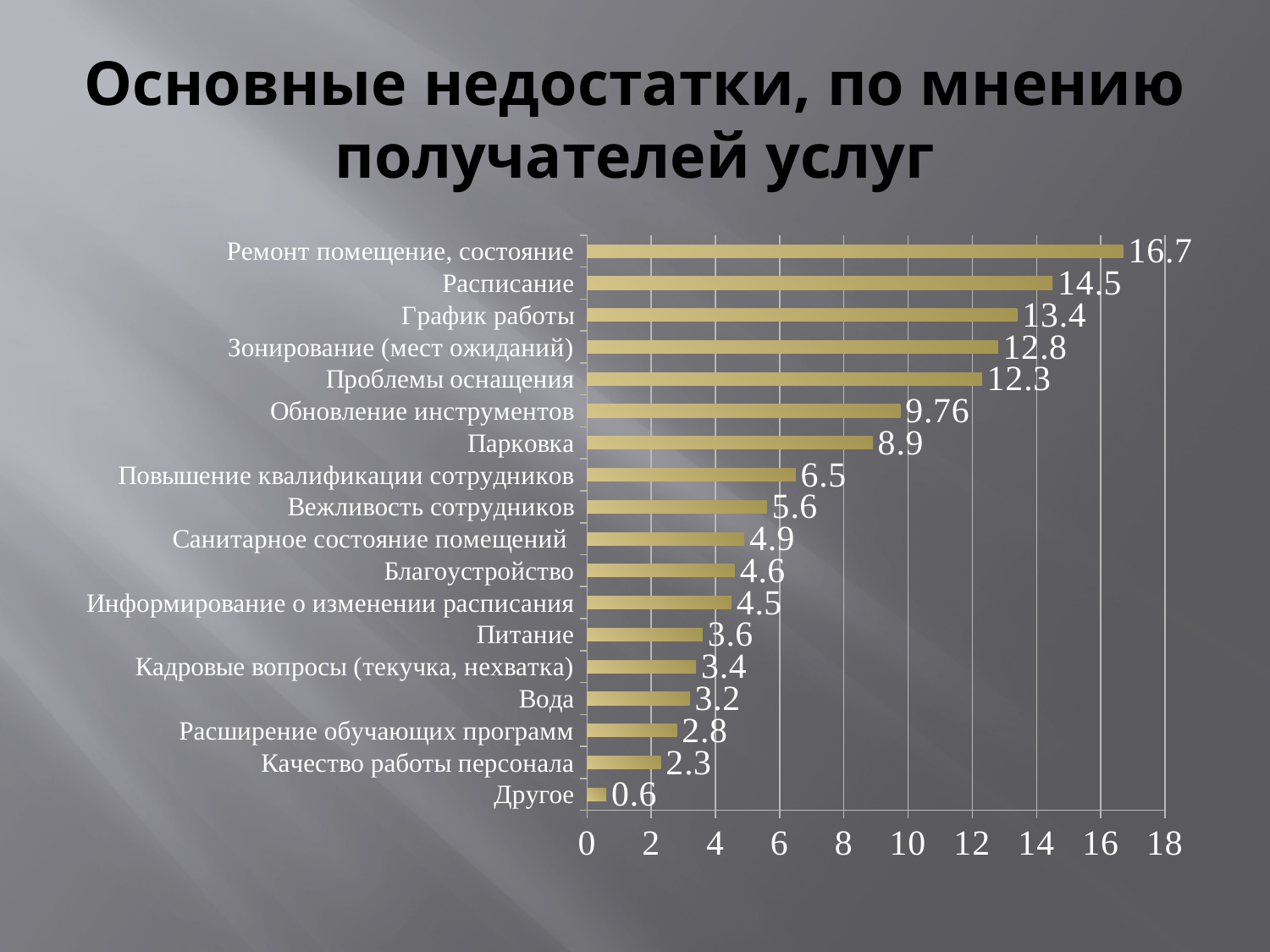
What is the value for Обновление инструментов? 9.76 What is the title of the slide? Основные недостатки, по мнению получателей услуг What is the difference between the values for Ремонт помещение, состояние and Расписание? 2.2 How many categories are shown in the chart? 18 What is the value for Расписание? 14.5 What kind of chart is shown on the slide? bar chart Is the value for Зонирование (мест ожиданий) greater or less than 10? greater Which is larger, the value for График работы or the value for Проблемы оснащения? График работы What is the difference between the values for Питание and Вода? 0.4 What is the value for Парковка? 8.9 Which category has the lowest value? Другое Which category has the highest value? Ремонт помещение, состояние